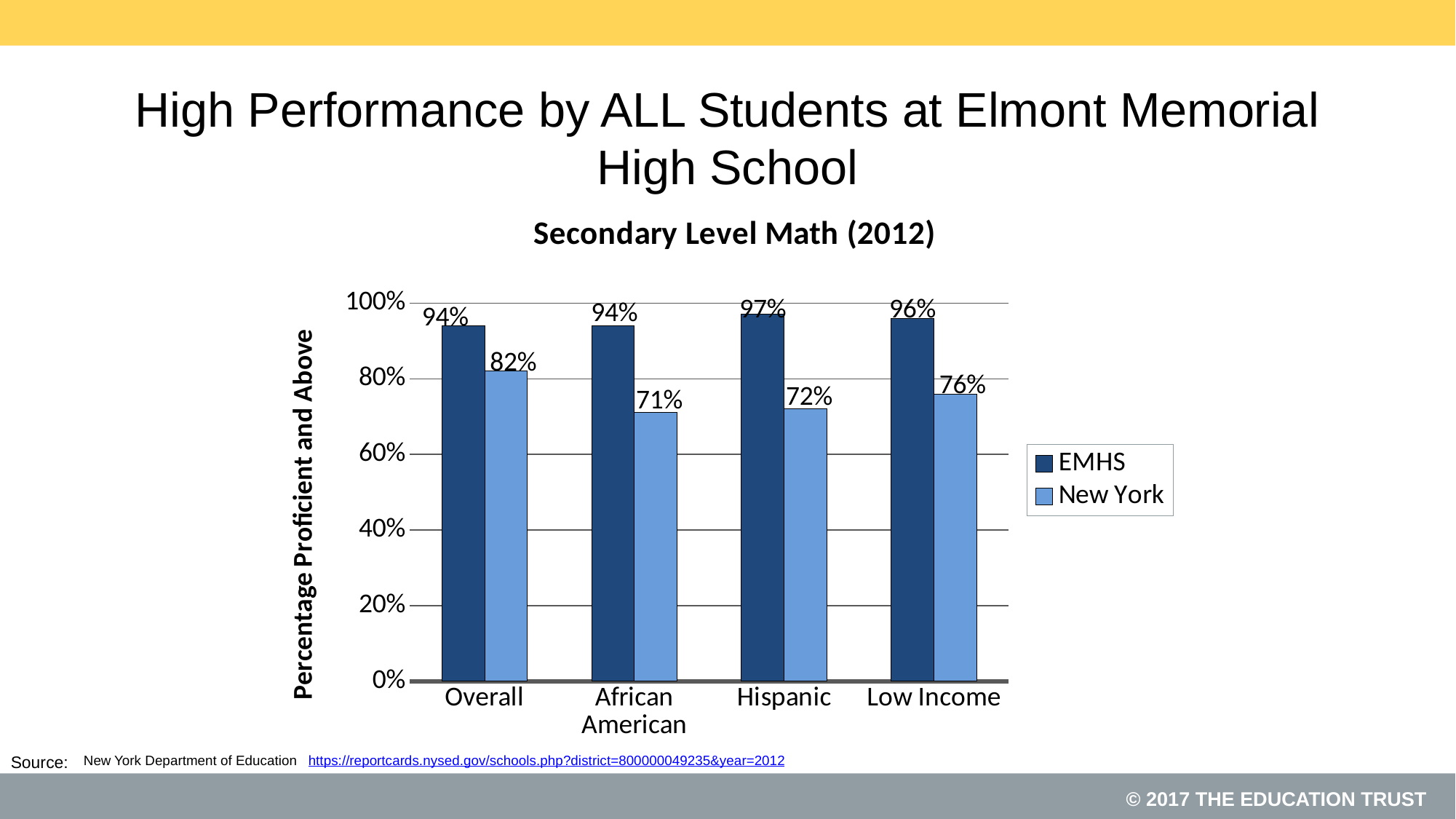
What is the New York value for Low Income students? 76% Which category has the highest EMHS value? Hispanic How many series does the legend list? 2 What is the title of the chart? Secondary Level Math (2012) What is the EMHS value for Hispanic students? 97% What is the New York value for African American students? 71% What is the difference between the EMHS and New York values for Hispanic students? 25% What kind of chart is shown? Bar chart How many categories are shown on the x axis? 4 Which category has the lowest New York value? African American What is the difference between the EMHS and New York values for Overall? 12% Which is larger, the New York value for Overall or the New York value for Low Income? Overall